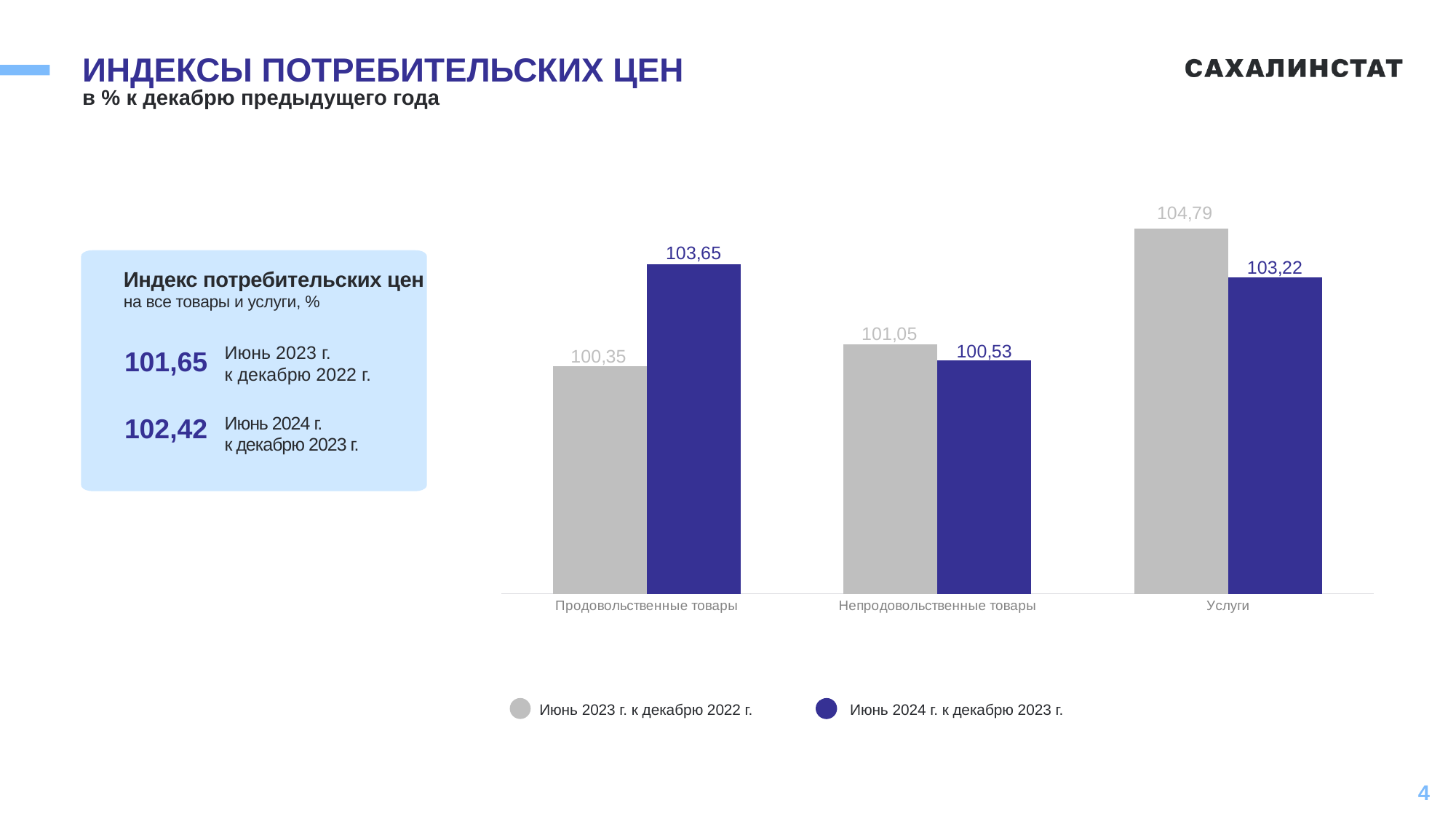
What is the value for Услуги in the series Июнь 2023 г. к декабрю 2022 г.? 104,79 What is the value for Непродовольственные товары in the series Июнь 2024 г. к декабрю 2023 г.? 100,53 What is the value for Продовольственные товары in the series Июнь 2024 г. к декабрю 2023 г.? 103,65 Which category has the highest value in the series Июнь 2023 г. к декабрю 2022 г.? Услуги What kind of chart is shown on the slide? Bar chart How many categories are shown on the x axis of the chart? 3 For Непродовольственные товары, which series has the larger value: Июнь 2023 г. к декабрю 2022 г. or Июнь 2024 г. к декабрю 2023 г.? Июнь 2023 г. к декабрю 2022 г. How many series does the chart legend list? 2 Which colour represents the series Июнь 2024 г. к декабрю 2023 г. in the chart? Dark blue What is the difference between the two series values for Продовольственные товары? 3,30 What is the difference between the Июнь 2023 г. к декабрю 2022 г. and Июнь 2024 г. к декабрю 2023 г. values for Услуги? 1,57 Which category has the lowest value in the series Июнь 2024 г. к декабрю 2023 г.? Непродовольственные товары